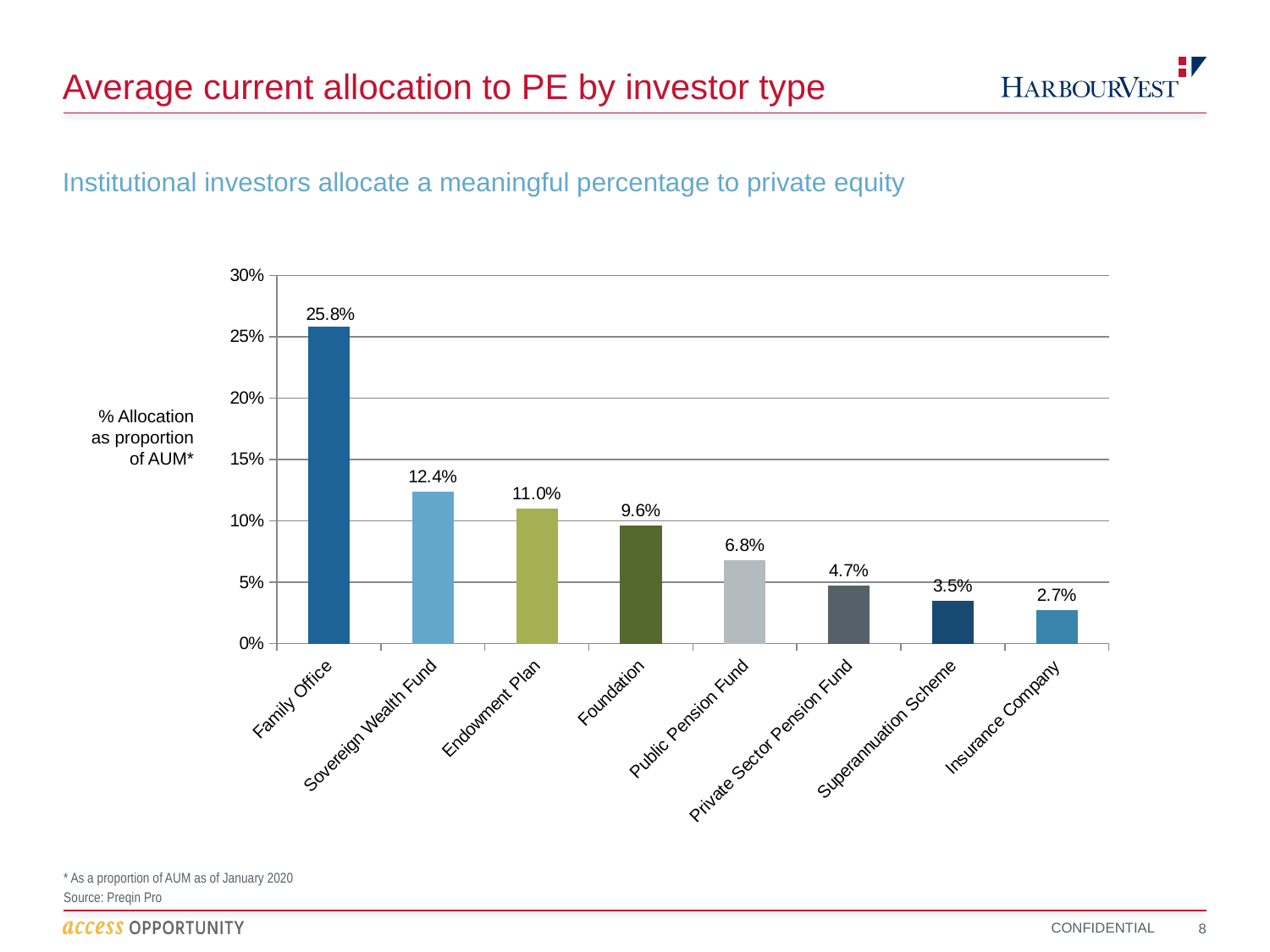
Which investor type has the lowest average current allocation to PE? Insurance Company What is the average current allocation to PE for Superannuation Scheme? 3.5% What is the difference between the allocation for Sovereign Wealth Fund and Endowment Plan? 1.4% What is the label on the vertical axis of the chart? % Allocation as proportion of AUM* Which has a larger allocation to PE, Foundation or Private Sector Pension Fund? Foundation What is the difference between the allocation for Family Office and Insurance Company? 23.1% Which investor type has the highest average current allocation to PE? Family Office Is the value for Endowment Plan greater or less than 10%? greater What is the average current allocation to PE for Family Office? 25.8% How many investor types are shown in the chart? 8 What kind of chart is shown on the slide? Bar chart What is the average current allocation to PE for Public Pension Fund? 6.8%